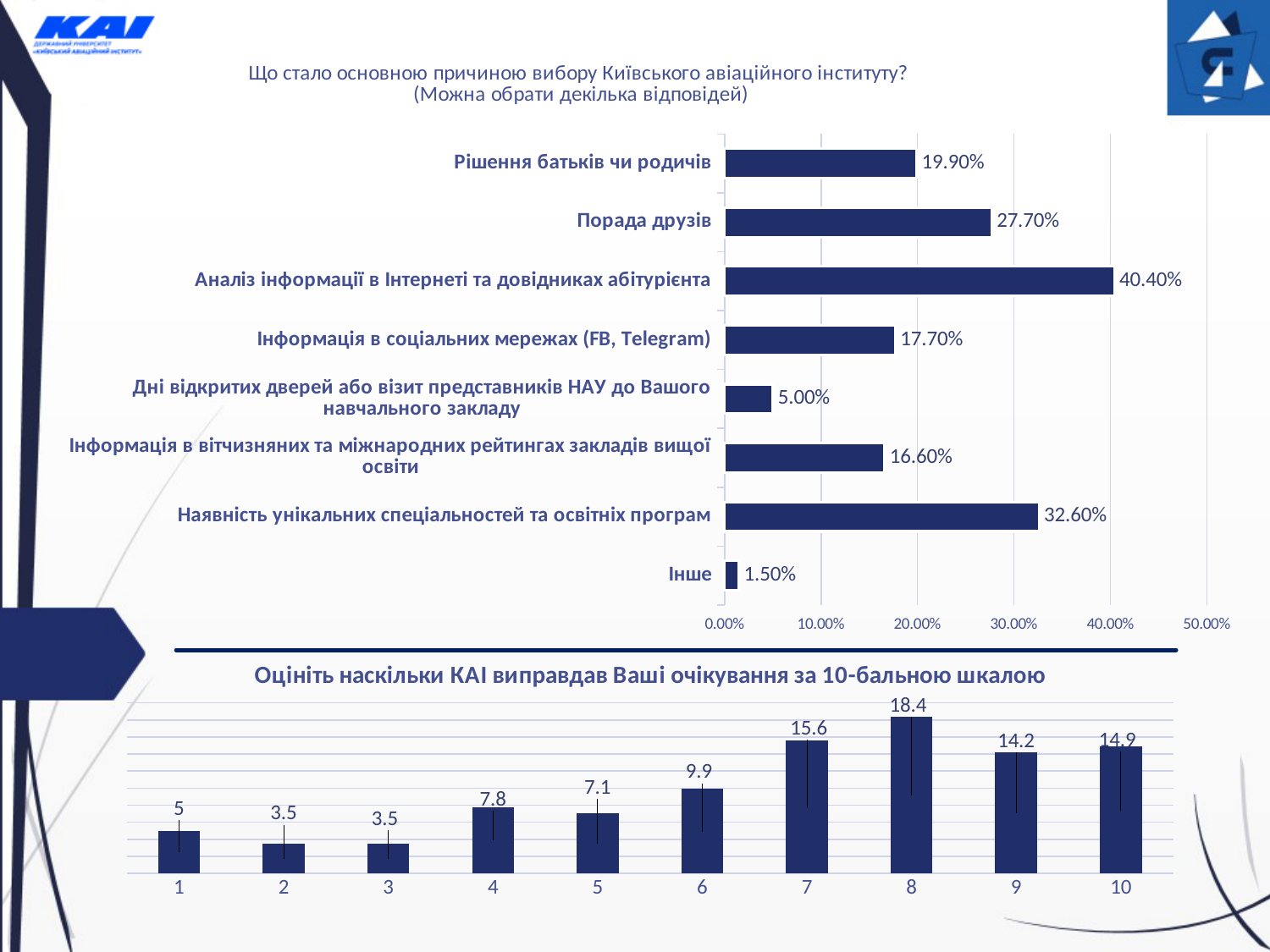
In the bottom chart "Оцініть наскільки КАІ виправдав Ваші очікування за 10-бальною шкалою", which score has the highest value? 8 In the top chart, which is larger: "Інформація в соціальних мережах (FB, Telegram)" or "Інформація в вітчизняних та міжнародних рейтингах закладів вищої освіти"? Інформація в соціальних мережах (FB, Telegram) In the top chart, what is the value for "Порада друзів"? 27.70% How many categories does the bottom chart "Оцініть наскільки КАІ виправдав Ваші очікування за 10-бальною шкалою" show? 10 What kind of chart is the top chart? Bar chart In the top chart, what is the value for "Аналіз інформації в Інтернеті та довідниках абітурієнта"? 40.40% In the top chart, which category has the lowest value? Інше How many categories does the top chart show? 8 In the top chart, what is the difference between "Наявність унікальних спеціальностей та освітніх програм" and "Рішення батьків чи родичів"? 12.70% In the bottom chart "Оцініть наскільки КАІ виправдав Ваші очікування за 10-бальною шкалою", what is the value for score 8? 18.4 In the bottom chart "Оцініть наскільки КАІ виправдав Ваші очікування за 10-бальною шкалою", what is the difference between the values for score 10 and score 9? 0.7 In the top chart, which category has the highest value? Аналіз інформації в Інтернеті та довідниках абітурієнта